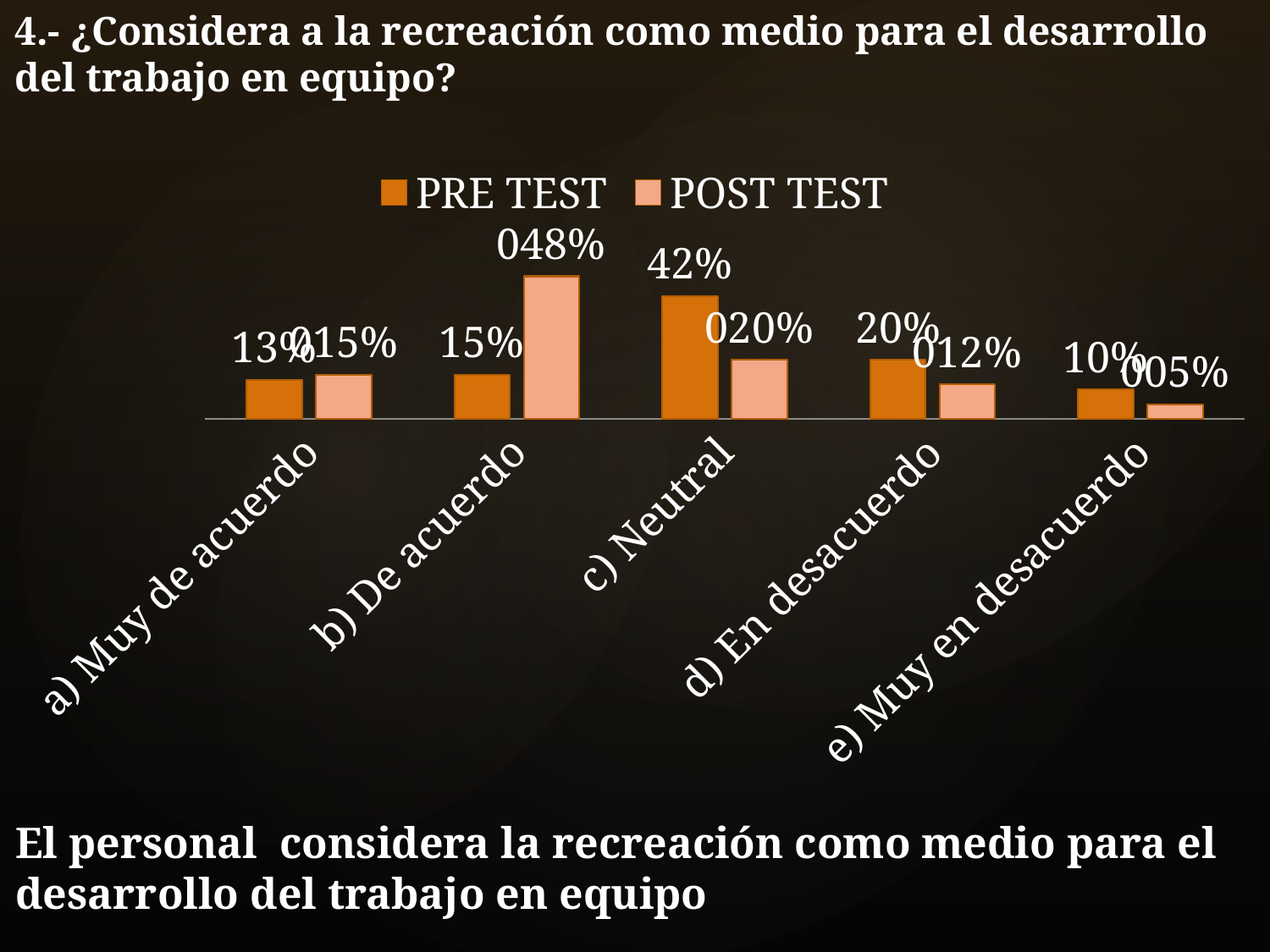
How many categories are shown on the x axis? 5 What type of chart is shown on the slide? bar chart Which category has the lowest POST TEST value? e) Muy en desacuerdo Which category has the highest PRE TEST value? c) Neutral How many series does the legend list? 2 What is the PRE TEST value for c) Neutral? 42% Which series is shown in the darker orange colour? PRE TEST What is the POST TEST value for b) De acuerdo? 048% What is the PRE TEST value for d) En desacuerdo? 20% For c) Neutral, which is larger, the PRE TEST or the POST TEST value? PRE TEST What is the POST TEST value for e) Muy en desacuerdo? 005% What is the difference between the PRE TEST values for c) Neutral and e) Muy en desacuerdo? 32%